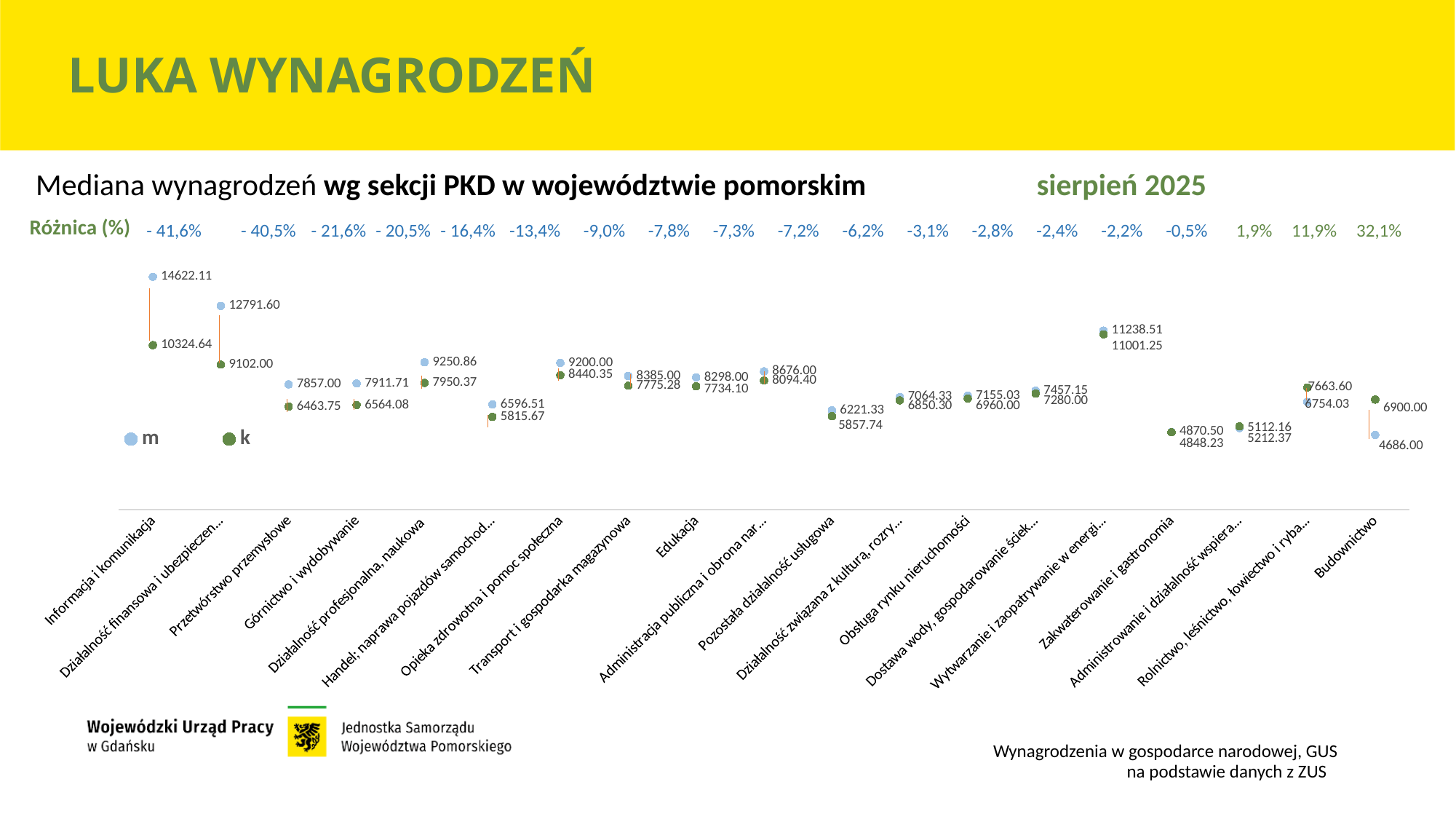
What is the median wage for series k in Edukacja? 7734.10 Which section has the lowest value for series m? Budownictwo Which section shows the largest positive percentage difference in the Różnica row? Budownictwo How many series does the legend list? 2 What kind of chart is shown on the slide? scatter (dot) chart How many PKD sections (categories) are plotted on the x axis? 19 What is the median wage for series m in Opieka zdrowotna i pomoc społeczna? 9200.00 Which section has the highest value for series m? Informacja i komunikacja What is the difference between the m and k values in Informacja i komunikacja? 4297.47 Which is larger: the m value for Górnictwo i wydobywanie or the m value for Przetwórstwo przemysłowe? Górnictwo i wydobywanie What percentage difference (Różnica) is shown for Edukacja? -7,3% What is the median wage for series m in Informacja i komunikacja? 14622.11